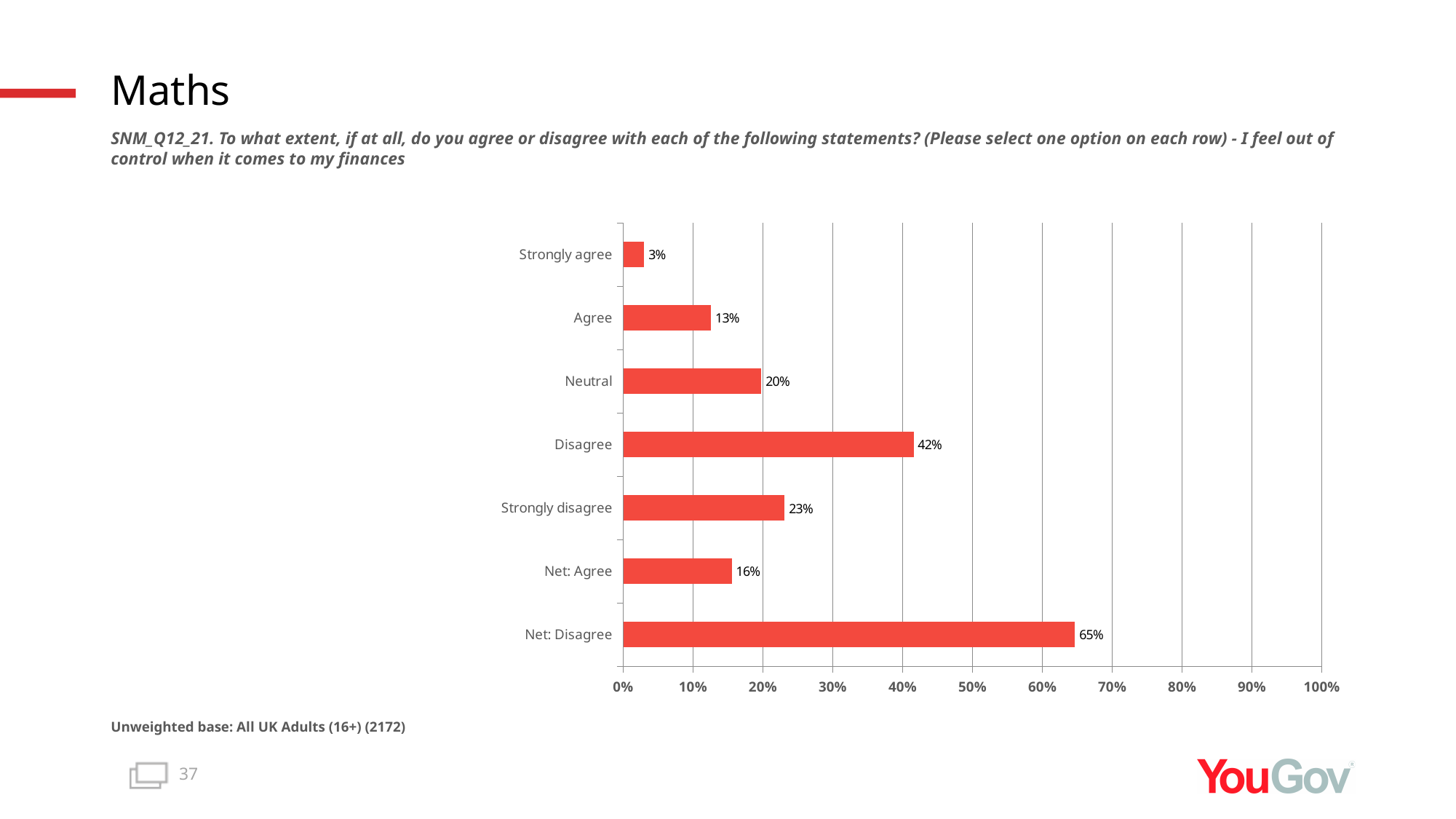
Which is larger, 'Strongly disagree' or 'Agree'? Strongly disagree How many categories are shown on the chart? 7 What kind of chart is shown on the slide? Bar chart Is the value for 'Disagree' greater or less than 50%? less What is the value shown for 'Neutral'? 20% What is the difference between 'Net: Disagree' and 'Net: Agree'? 49% What is the unweighted base stated below the chart? All UK Adults (16+) (2172) What is the value shown for 'Net: Disagree'? 65% What percentage of respondents selected 'Strongly agree'? 3% Which category has the highest value? Net: Disagree Which category has the lowest value? Strongly agree What percentage of respondents selected 'Disagree'? 42%